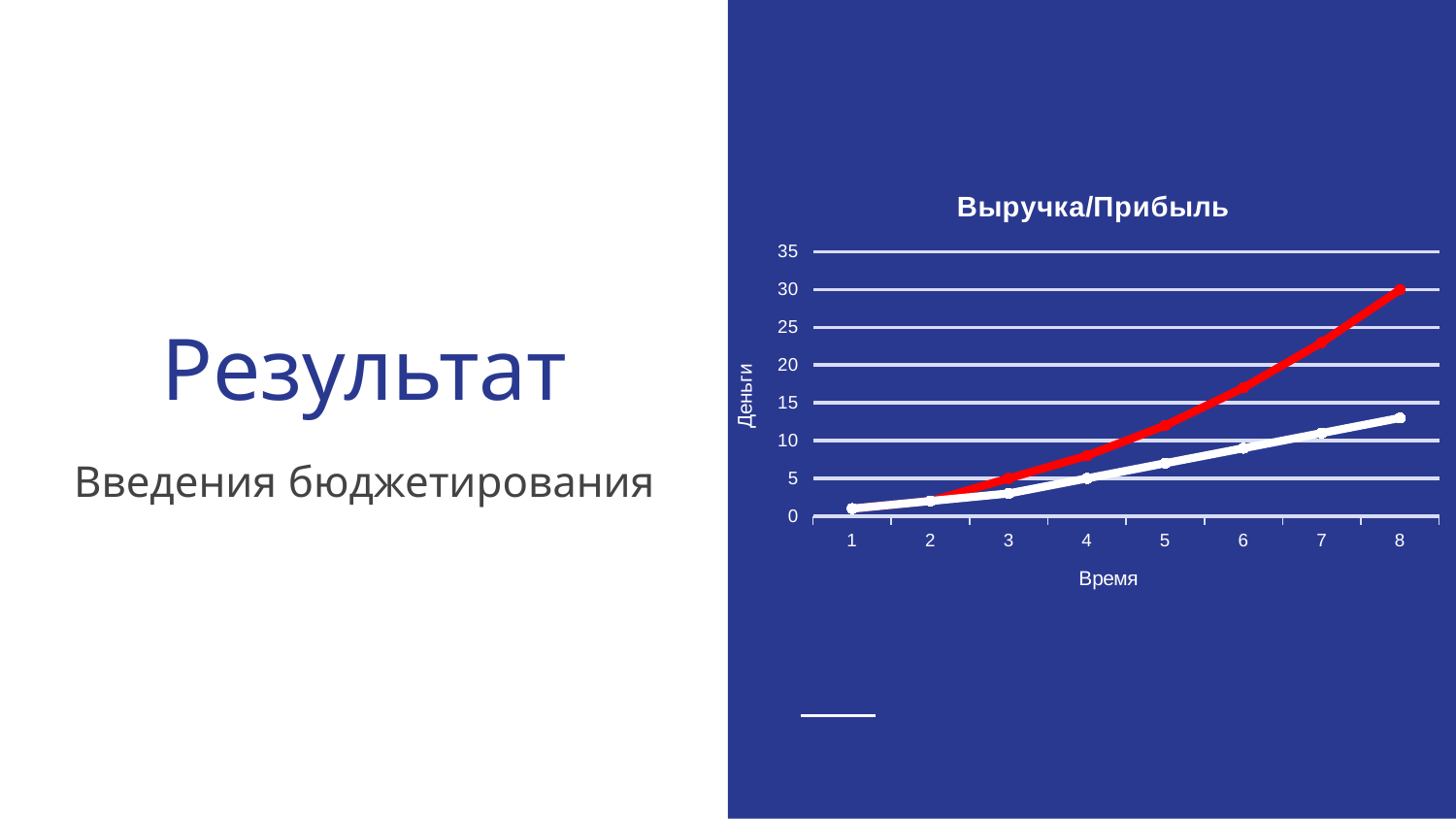
Is the value of the red line at x = 8 greater or less than 25? greater What is the title of the chart? Выручка/Прибыль What kind of chart is shown on the slide? line chart What is the label of the x axis of the chart? Время Is the value of the red line at x = 6 greater or less than 15? greater Is the value of the red line at x = 1 greater or less than 5? less Do the values of the red line rise or fall as the x axis goes from 1 to 8? rise At x = 8, which line has the larger value, the red line or the white line? the red line Do the values of the white line rise or fall as the x axis goes from 1 to 8? rise How many points are plotted along the x axis for each line? 8 How many lines are plotted on the chart? 2